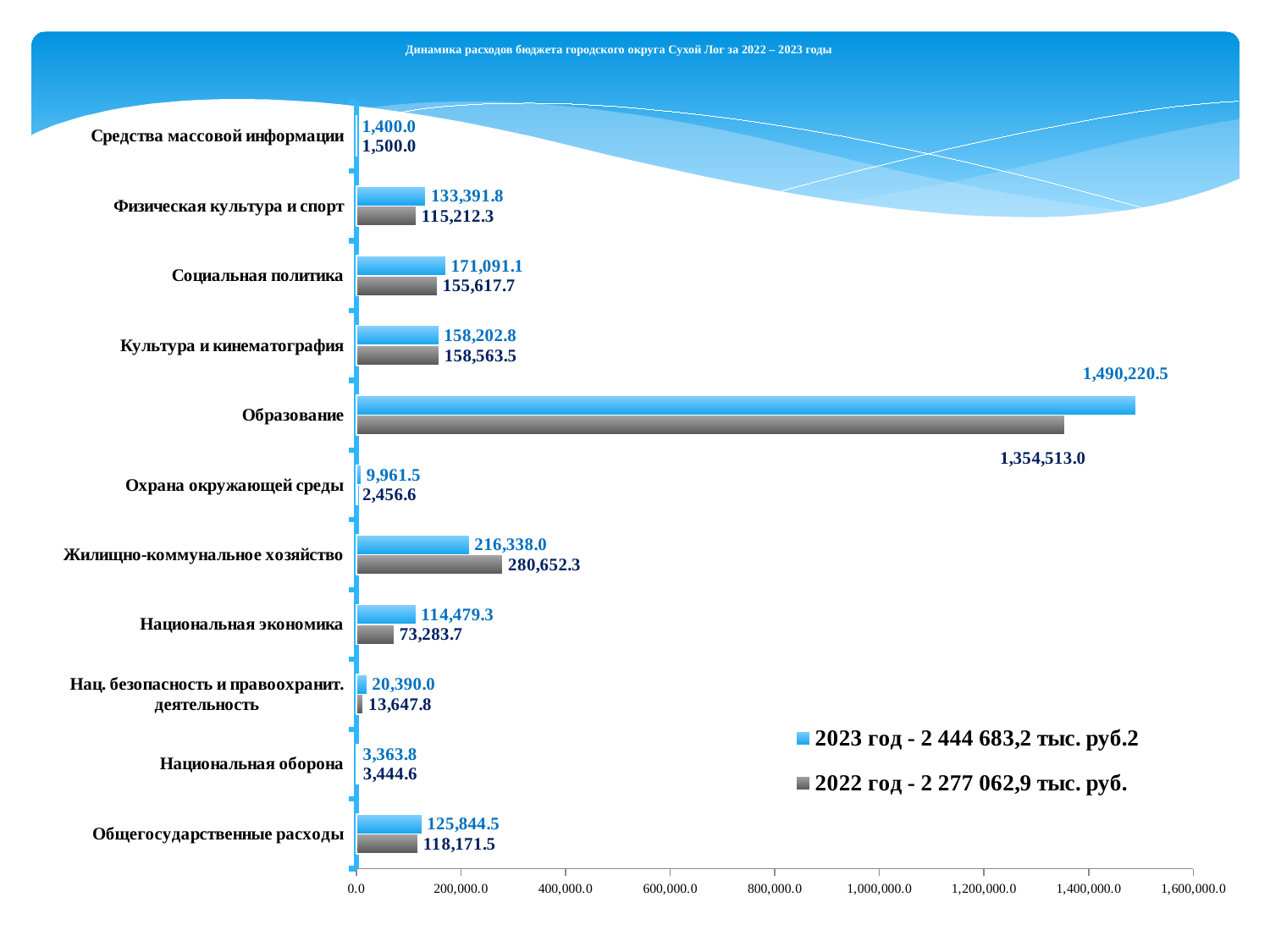
What colour are the bars for the 2022 series? Grey How many categories are shown on the chart? 11 Is the 2023 value for Социальная политика greater or less than 200,000.0? less What is the 2023 value for Образование? 1,490,220.5 How many series does the legend list? 2 What is the 2023 value for Охрана окружающей среды? 9,961.5 Which is larger for Жилищно-коммунальное хозяйство: the 2023 value or the 2022 value? 2022 value What is the difference between the 2023 and 2022 values for Образование? 135,707.5 What type of chart is shown on the slide? Bar chart Which category has the lowest 2023 value? Средства массовой информации What is the 2022 value for Жилищно-коммунальное хозяйство? 280,652.3 Which category has the highest 2023 value? Образование